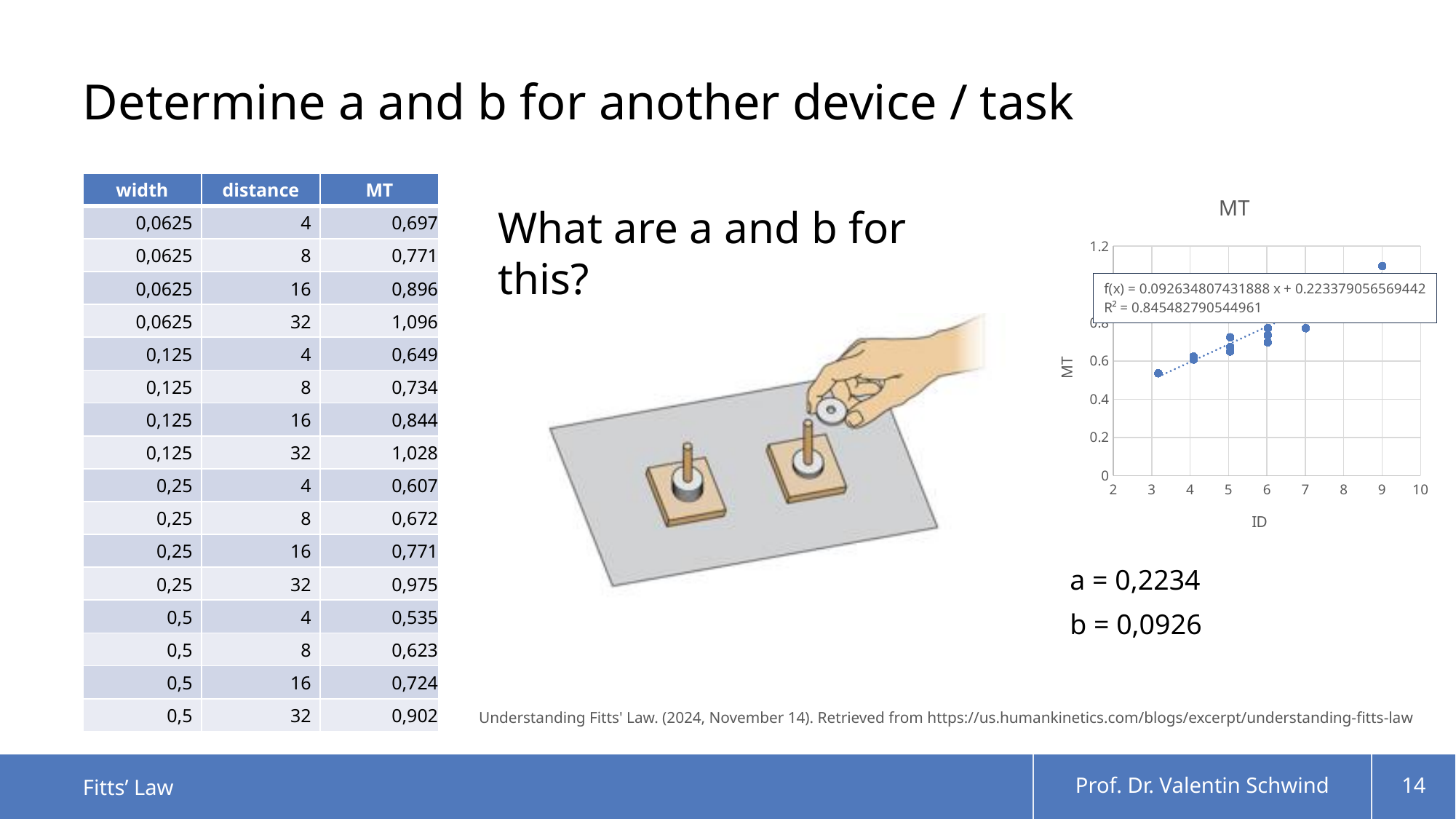
What is the highest tick value shown on the x axis of the MT chart? 10 What kind of chart is shown on the right of the slide? scatter chart What is the highest tick value shown on the y axis of the MT chart? 1.2 In the MT chart, do the MT values rise or fall as ID increases? rise What is the trendline equation shown in the MT chart? f(x) = 0.092634807431888 x + 0.223379056569442 In the MT chart, is the value of the point at ID 9 greater or less than 1.0? greater What is the label of the x axis of the MT chart? ID What is the title of the chart on the right of the slide? MT What R² value is shown in the MT chart? 0.845482790544961 In the MT chart, is the value of the point at ID 7 greater or less than 0.6? greater In the MT chart, is the value of the point at ID 3 greater or less than 0.6? less In the MT chart, which point has the highest MT value: the one at ID 9 or the one at ID 3? the one at ID 9